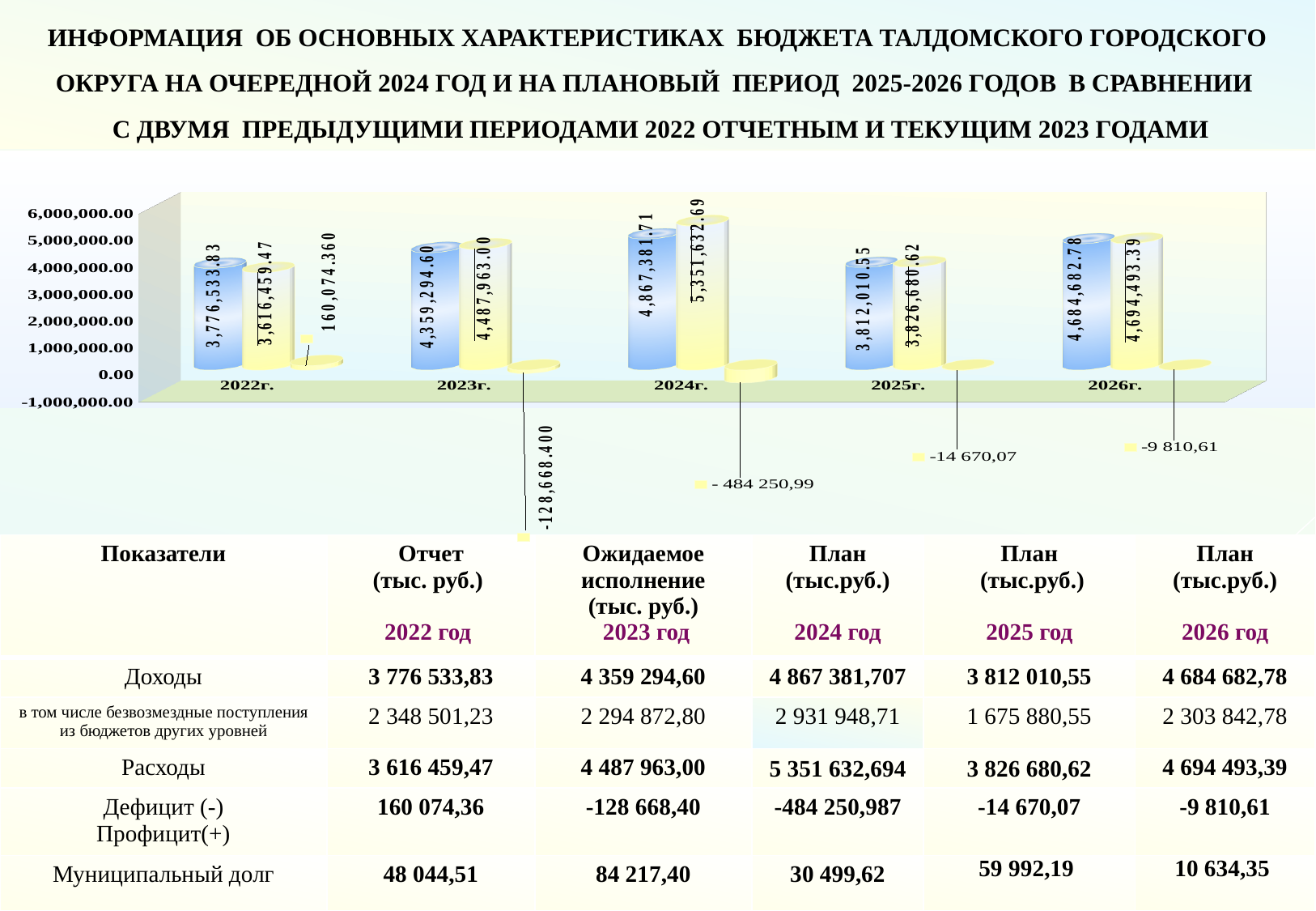
For 2023г., which is larger: the blue bar or the yellow bar? the yellow bar In which year is the yellow bar the tallest? 2024г. What is the difference between the blue bar and the yellow bar for 2022г.? 160,074.36 What is the value labelled on the yellow bar for 2026г.? 4,694,493.39 What kind of chart is shown on the slide? bar chart In which year is the blue bar the shortest? 2022г. Is the value of the blue bar for 2024г. greater or less than 4,000,000.00? greater What is the value labelled on the blue bar for 2022г.? 3,776,533.83 What value is labelled for the small third bar in 2025г.? -14 670,07 What is the value labelled on the yellow bar for 2024г.? 5,351,632.69 How many year categories are shown along the x axis of the chart? 5 Do the blue bars rise or fall from 2022г. to 2024г.? rise